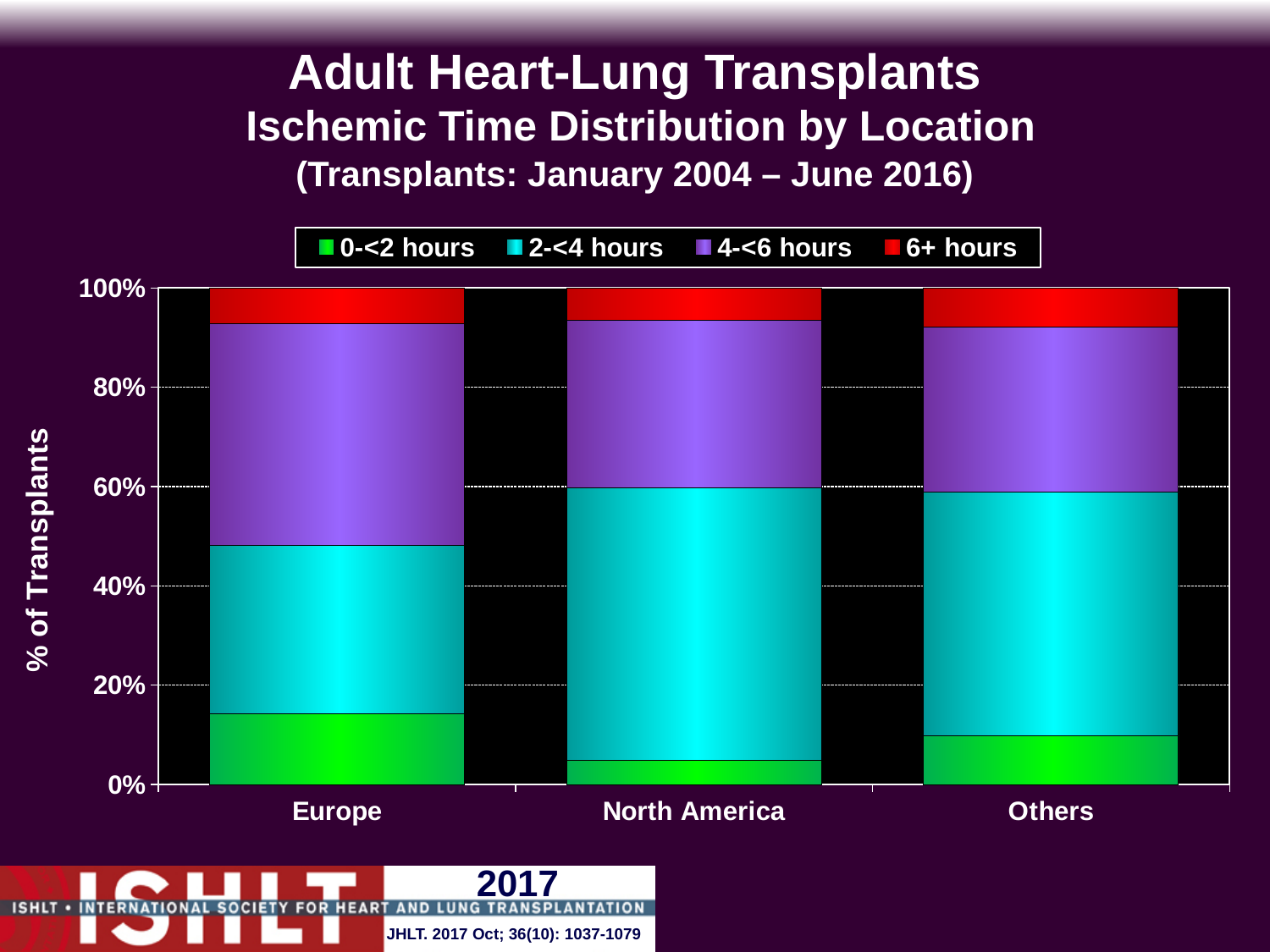
What kind of chart is shown on the slide? Stacked bar chart How many series does the legend list? 4 Which location has the largest 2-<4 hours segment? North America Which location has the smallest 0-<2 hours segment? North America How many locations are shown on the x axis? 3 Which location has the largest 0-<2 hours segment? Europe Is the 0-<2 hours segment for Europe greater or less than 20%? less Is the 2-<4 hours segment for North America greater or less than 40%? greater Which is larger: the 4-<6 hours segment for Europe or for North America? Europe What is the total height of the stacked bar for Europe? 100% What is the label of the y axis? % of Transplants Is the 4-<6 hours segment for Others greater or less than 40%? less